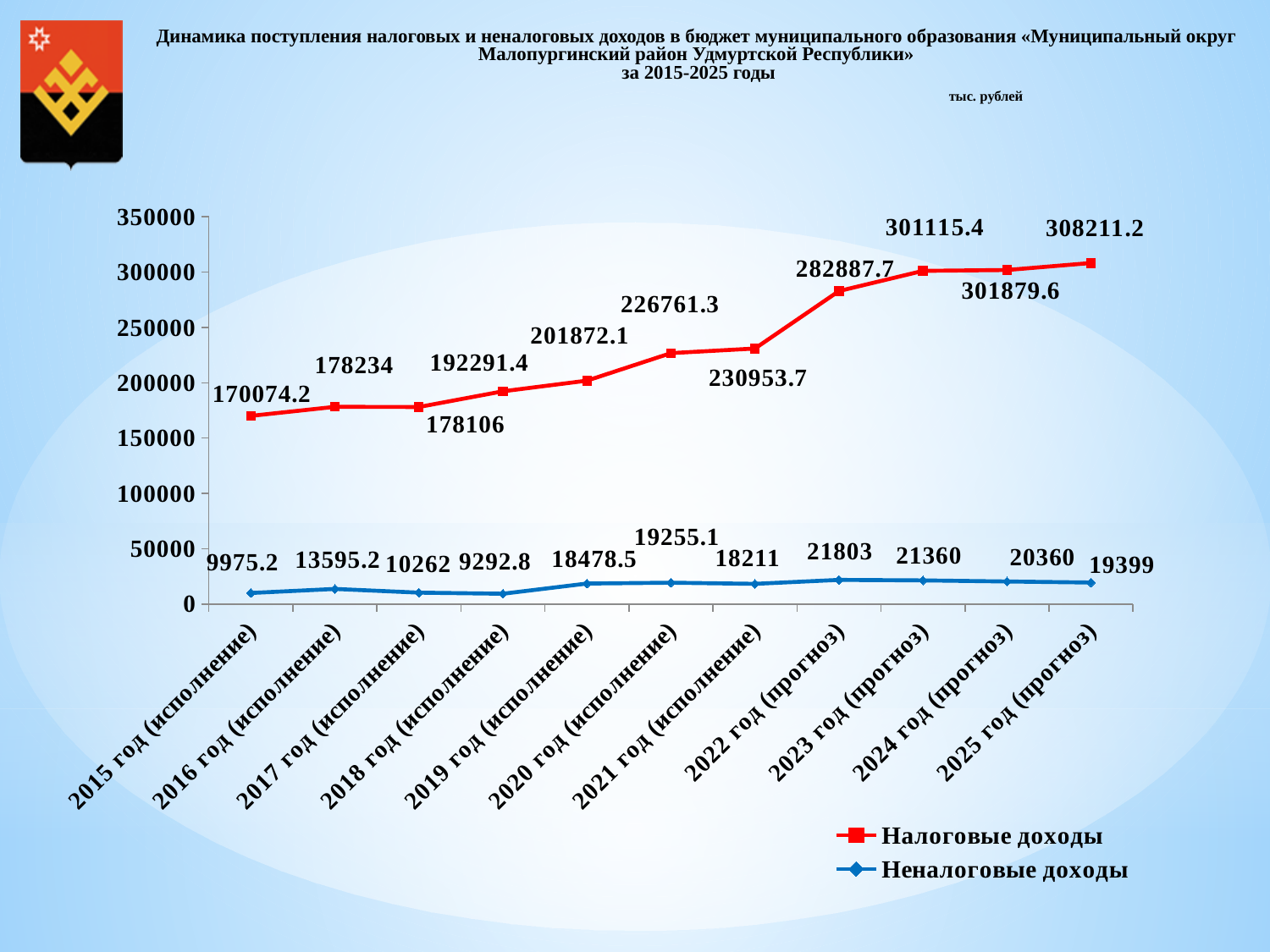
How many series does the legend list? 2 In which year is Налоговые доходы highest? 2025 год (прогноз) What is the value of Неналоговые доходы for 2022 год (прогноз)? 21803 How many years are shown on the x axis? 11 What is the value of Налоговые доходы for 2020 год (исполнение)? 226761.3 What kind of chart is shown on the slide? line chart Which is larger: Неналоговые доходы in 2023 год (прогноз) or in 2024 год (прогноз)? 2023 год (прогноз) Do the values of Налоговые доходы generally rise or fall from 2015 to 2025? rise Is the value of Налоговые доходы for 2022 год (прогноз) greater or less than 250000? greater What is the value of Налоговые доходы for 2015 год (исполнение)? 170074.2 What is the difference between Налоговые доходы in 2025 год (прогноз) and 2015 год (исполнение)? 138137 In which year is Неналоговые доходы lowest? 2018 год (исполнение)